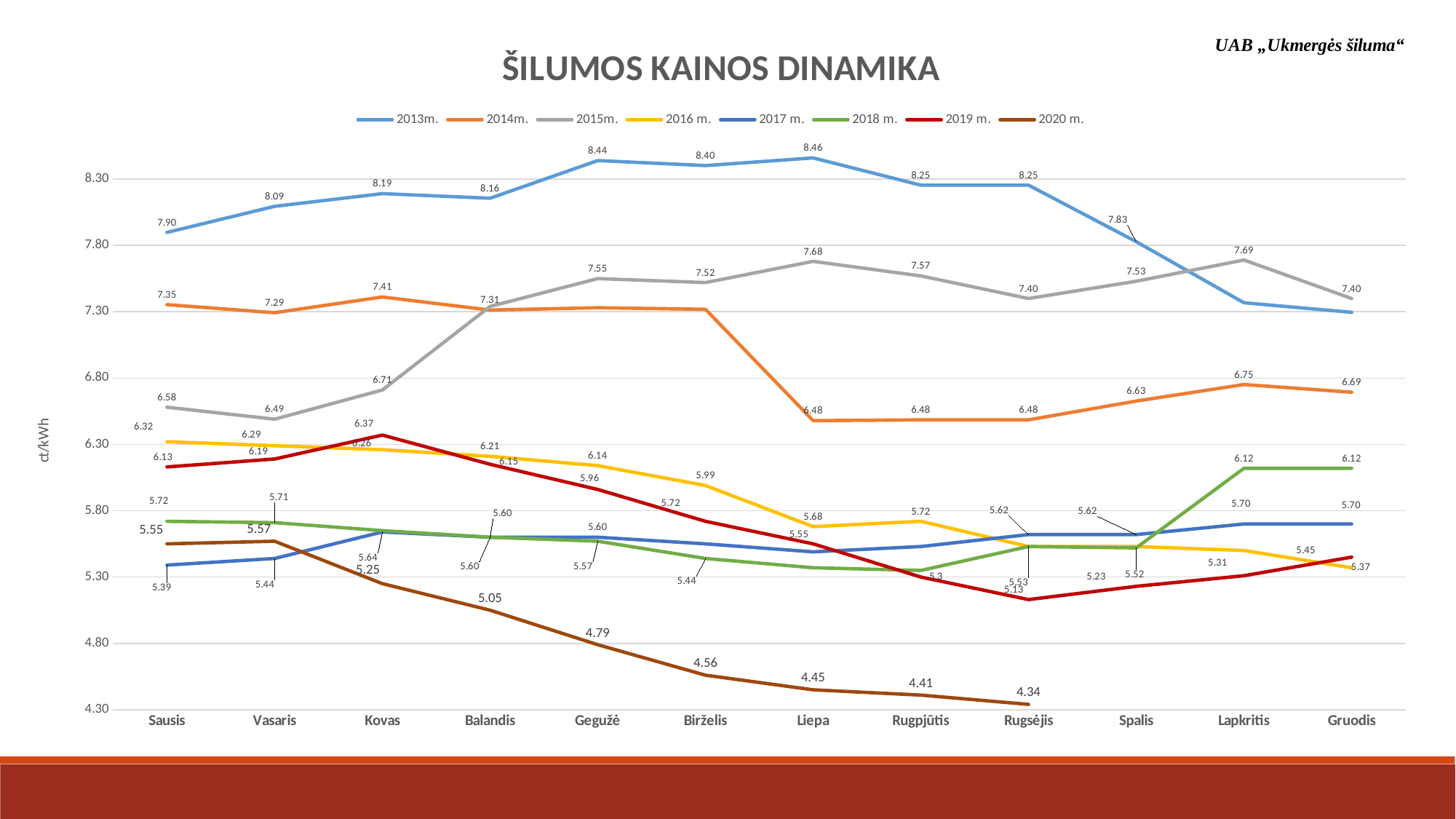
What is the value for 2013m. in Liepa? 8.46 Do the values of the 2020 m. series rise or fall from Sausis to Rugsėjis? fall What is the value for 2020 m. in Rugsėjis? 4.34 What is the difference between the 2013m. values in Liepa (8.46) and Sausis (7.90)? 0.56 Which is larger in Sausis: the value for 2013m. or the value for 2014m.? 2013m. What kind of chart is shown on the slide? line chart What is the label on the vertical axis? ct/kWh How many series does the legend list? 8 What is the value for 2014m. in Liepa? 6.48 How many months are shown along the x axis? 12 What is the value for 2015m. in Lapkritis? 7.69 In which month does the 2013m. series reach its highest value? Liepa